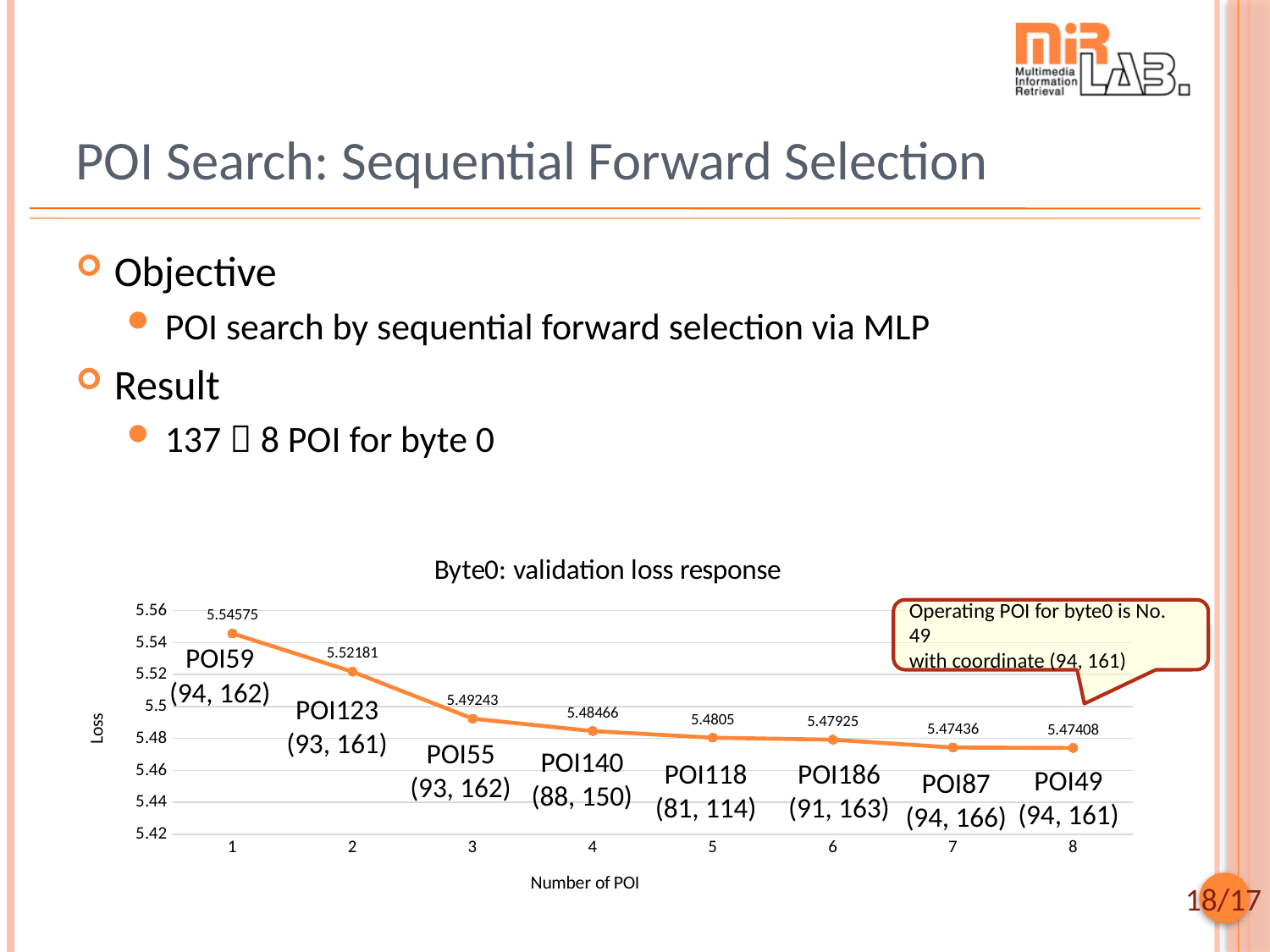
What is the loss value when the number of POI is 1? 5.54575 What is the loss value when the number of POI is 5? 5.4805 What type of chart is shown on the slide? line chart Which is larger, the loss at 4 POI or the loss at 6 POI? 4 POI How many data points are plotted on the chart? 8 Does the loss rise or fall as the number of POI increases? fall At which number of POI is the loss lowest? 8 What is the title of the chart? Byte0: validation loss response At which number of POI is the loss highest? 1 What is the loss value when the number of POI is 3? 5.49243 What is the difference between the loss at 1 POI and the loss at 2 POI? 0.02394 What is the loss value when the number of POI is 8? 5.47408